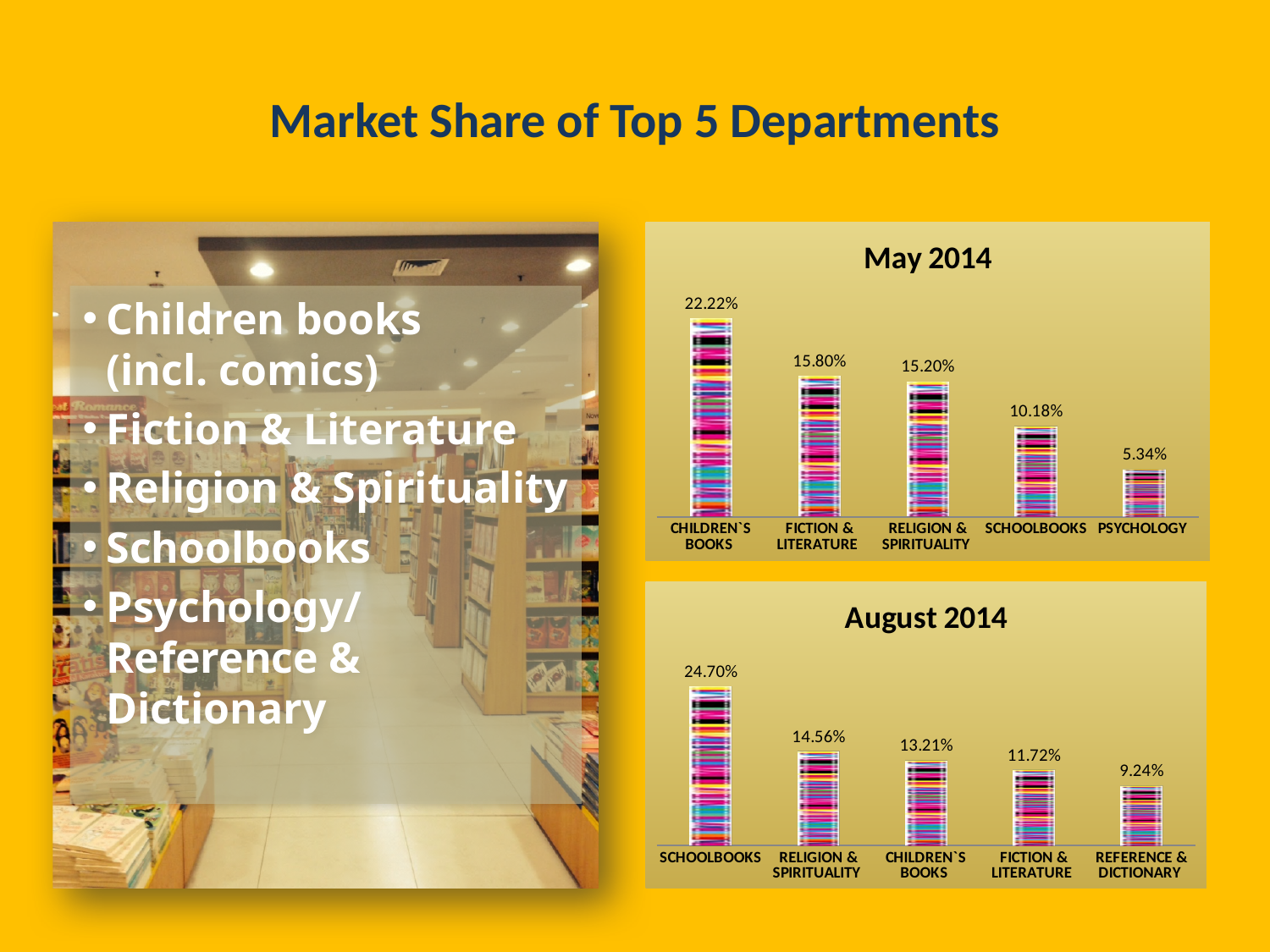
In the August 2014 chart, what is the difference between the market shares of Schoolbooks and Religion & Spirituality? 10.14% In the August 2014 chart, do the values rise or fall from left to right? Fall In the May 2014 chart, what is the market share of Children's Books? 22.22% What type of chart is the August 2014 chart? Bar chart In the May 2014 chart, what is the difference between the market shares of Fiction & Literature and Schoolbooks? 5.62% In the May 2014 chart, which department has the highest market share? Children's Books In the May 2014 chart, what is the market share of Psychology? 5.34% In the August 2014 chart, what is the market share of Reference & Dictionary? 9.24% In the August 2014 chart, which is larger: the market share of Children's Books or Fiction & Literature? Children's Books In the August 2014 chart, what is the market share of Schoolbooks? 24.70% How many departments are shown in the May 2014 chart? 5 In the August 2014 chart, which department has the lowest market share? Reference & Dictionary